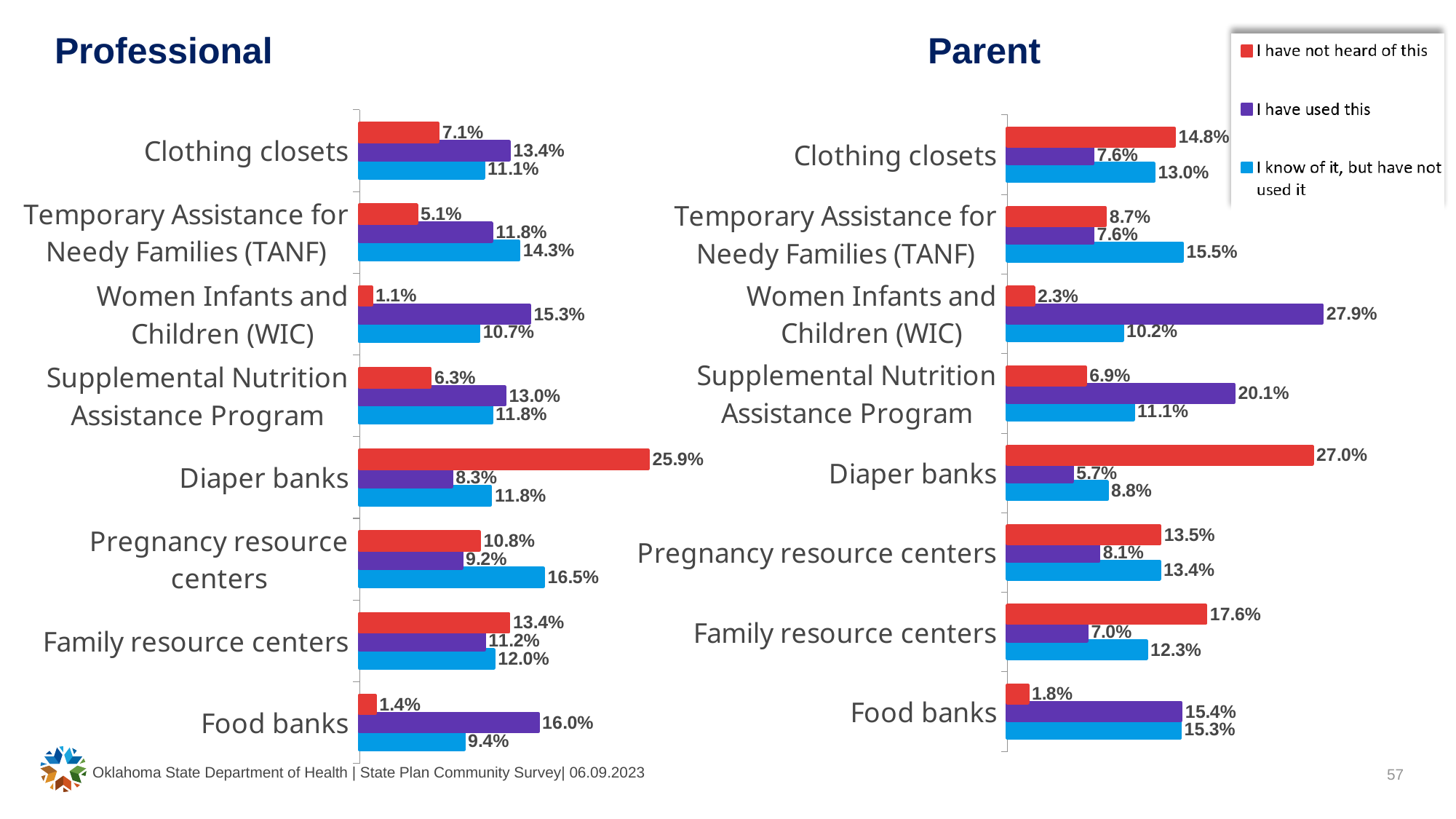
In the Professional chart, what percentage of respondents said they have used Food banks? 16.0% In the Professional chart, which category has the highest 'I have not heard of this' value? Diaper banks What type of chart is the Professional chart? Bar chart In the Parent chart, which category has the lowest 'I have used this' value? Diaper banks How many categories are shown in the Parent chart? 8 In the Parent chart, what percentage of respondents said they have not heard of Diaper banks? 27.0% In the Professional chart, which category has the lowest 'I have not heard of this' value? Women Infants and Children (WIC) Which colour represents 'I have used this' in the legend? Purple In the Professional chart, what is the difference between the 'I have not heard of this' values for Diaper banks and Family resource centers? 12.5% How many series does the legend list? 3 In the Parent chart, which is larger for Clothing closets: 'I have not heard of this' or 'I know of it, but have not used it'? I have not heard of this In the Parent chart, what percentage said they have used Women Infants and Children (WIC)? 27.9%